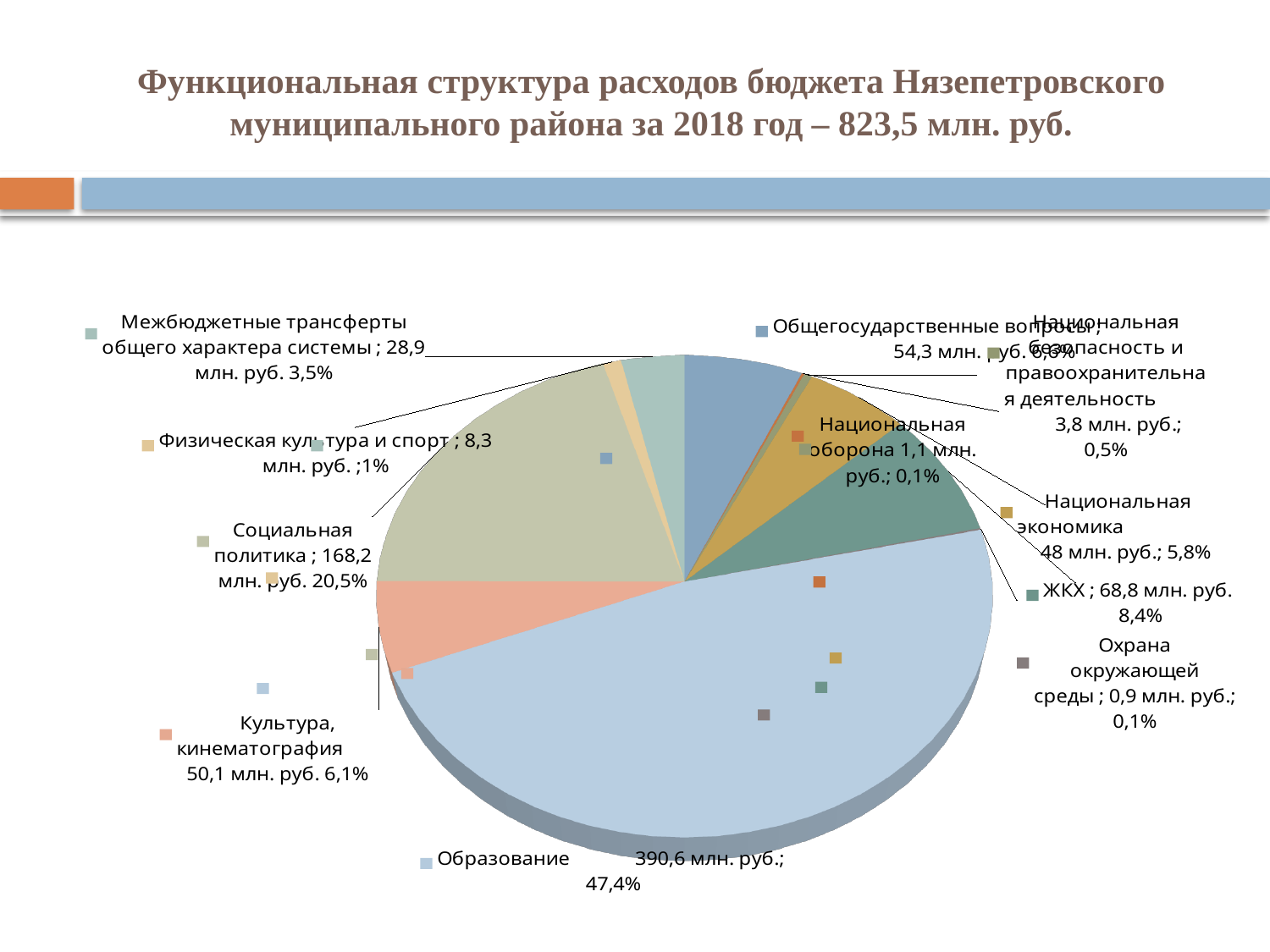
Which category has the largest share of the budget expenditure? Образование Which is larger: Культура, кинематография or Общегосударственные вопросы? Общегосударственные вопросы Which category has the smallest value in млн. руб.? Охрана окружающей среды What total budget expenditure for 2018 is stated in the slide title? 823,5 млн. руб. What is the value for Культура, кинематография? 50,1 млн. руб. What percentage share does Национальная экономика have? 5,8% What is the difference between Образование and Социальная политика in млн. руб.? 222,4 млн. руб. What is the value for Социальная политика? 168,2 млн. руб. What share of expenditure does Образование account for? 47,4% What is the value for ЖКХ? 68,8 млн. руб. What kind of chart is shown on the slide? pie chart How many categories are shown in the pie chart? 11